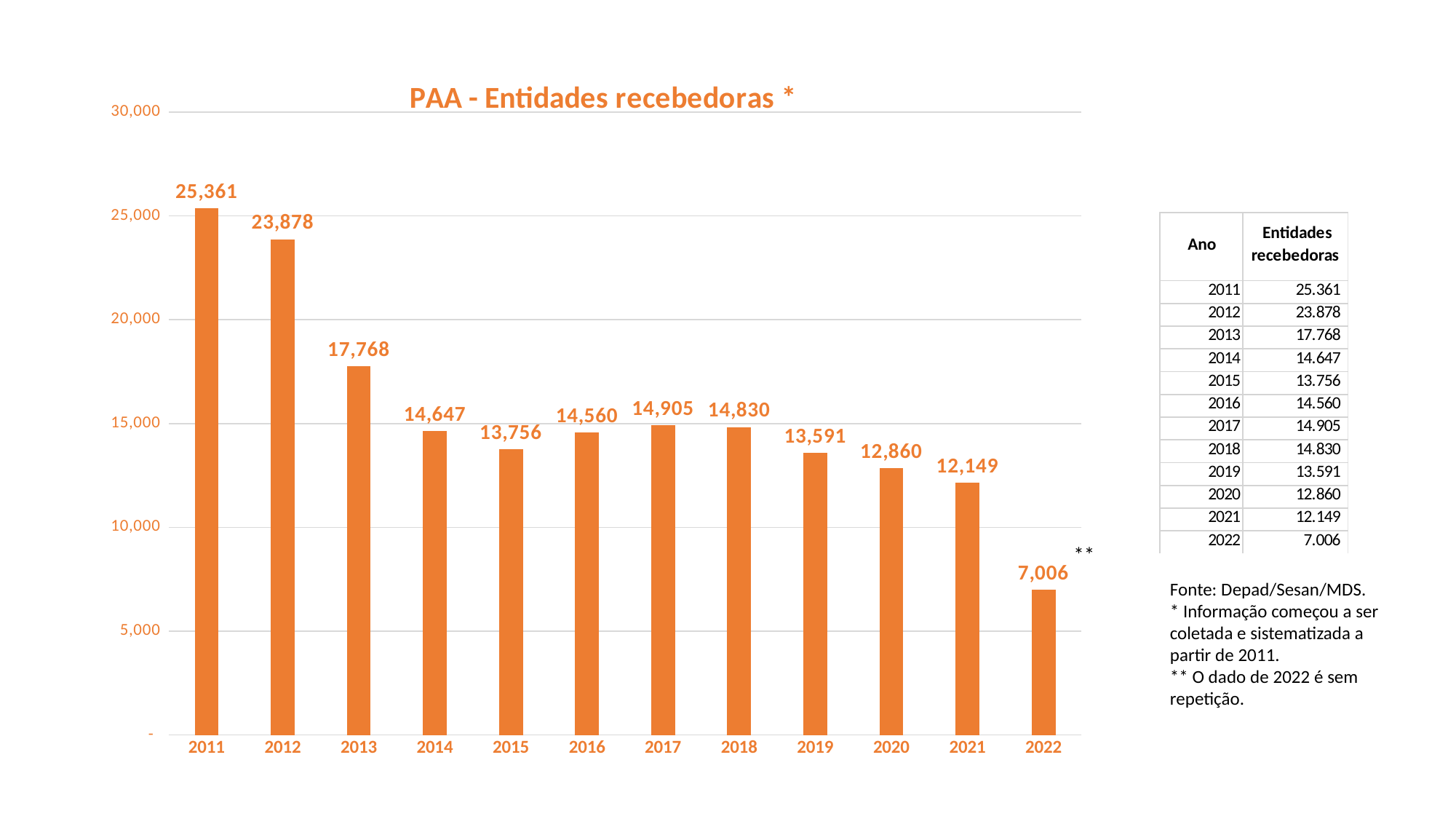
What is the value for 2022 in the chart? 7,006 What kind of chart is shown on the slide? bar chart Which year has the highest value in the chart? 2011 Which is larger, the value for 2013 or the value for 2014? 2013 How many years are shown on the x axis of the chart? 12 What is the difference between the values for 2011 and 2012? 1,483 Which year has the lowest value in the chart? 2022 What is the difference between the values for 2021 and 2022? 5,143 What is the value for 2017 in the chart? 14,905 What is the value for 2011 in the chart? 25,361 Is the value for 2020 greater or less than 15,000? less Do the values generally rise or fall from 2011 to 2022? fall